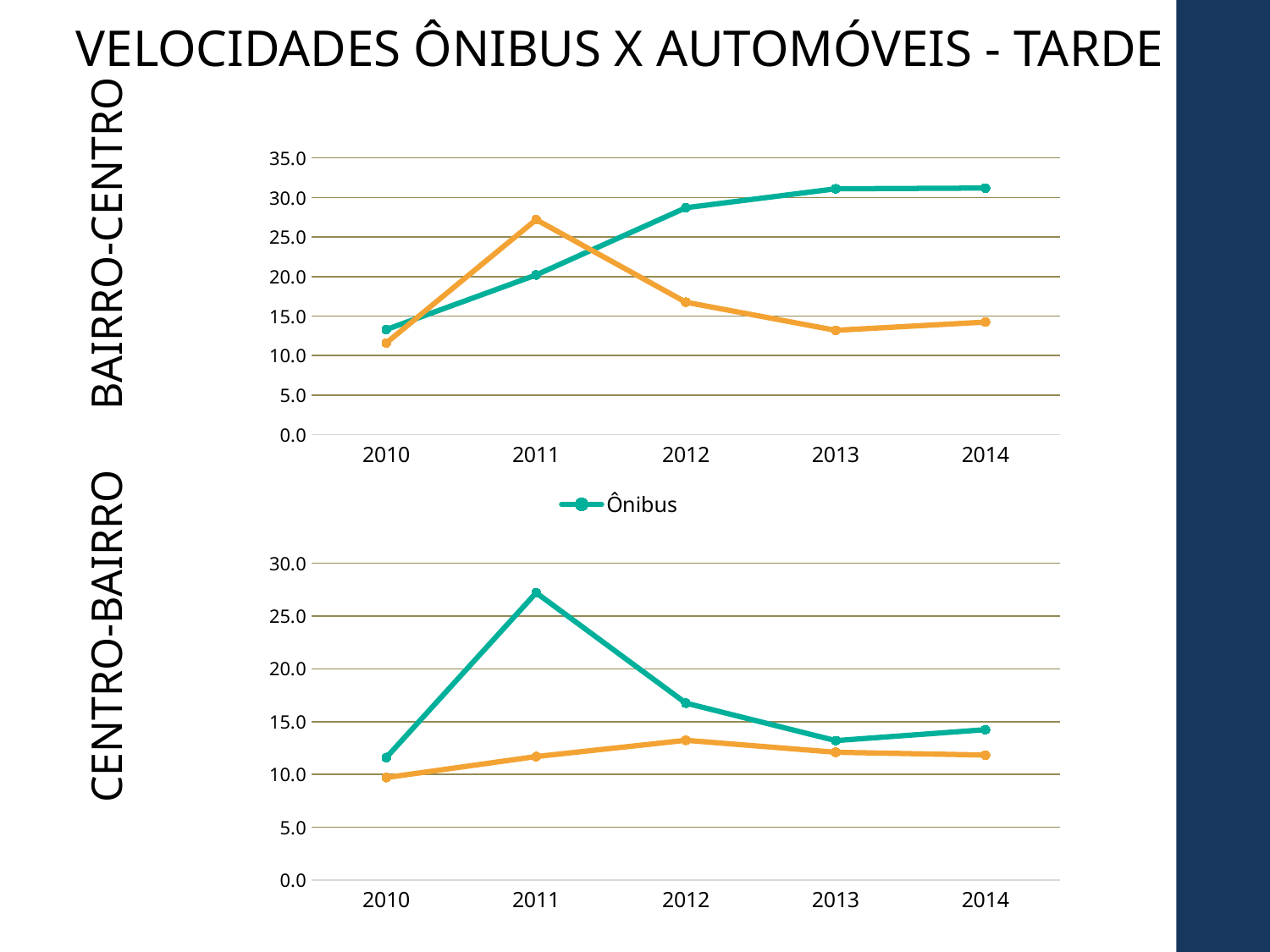
In the BAIRRO-CENTRO chart, is the Ônibus value for 2012 greater or less than 25.0? greater In the CENTRO-BAIRRO chart, is the Ônibus value for 2011 greater or less than 25.0? greater How many series does the legend on the slide list? 1 In the BAIRRO-CENTRO chart, is the Ônibus value larger in 2011 or in 2012? 2012 In the BAIRRO-CENTRO chart, is the Ônibus value for 2010 greater or less than 15.0? less In the BAIRRO-CENTRO chart, which year has the lowest Ônibus value? 2010 What is the name of the series listed in the legend? Ônibus How many years are shown on the x axis of the CENTRO-BAIRRO chart? 5 What kind of chart is the BAIRRO-CENTRO chart? line chart In the BAIRRO-CENTRO chart, does the Ônibus line rise or fall from 2010 to 2014? rises In the CENTRO-BAIRRO chart, which year has the highest Ônibus value? 2011 In the CENTRO-BAIRRO chart, is the Ônibus value larger in 2012 or in 2013? 2012